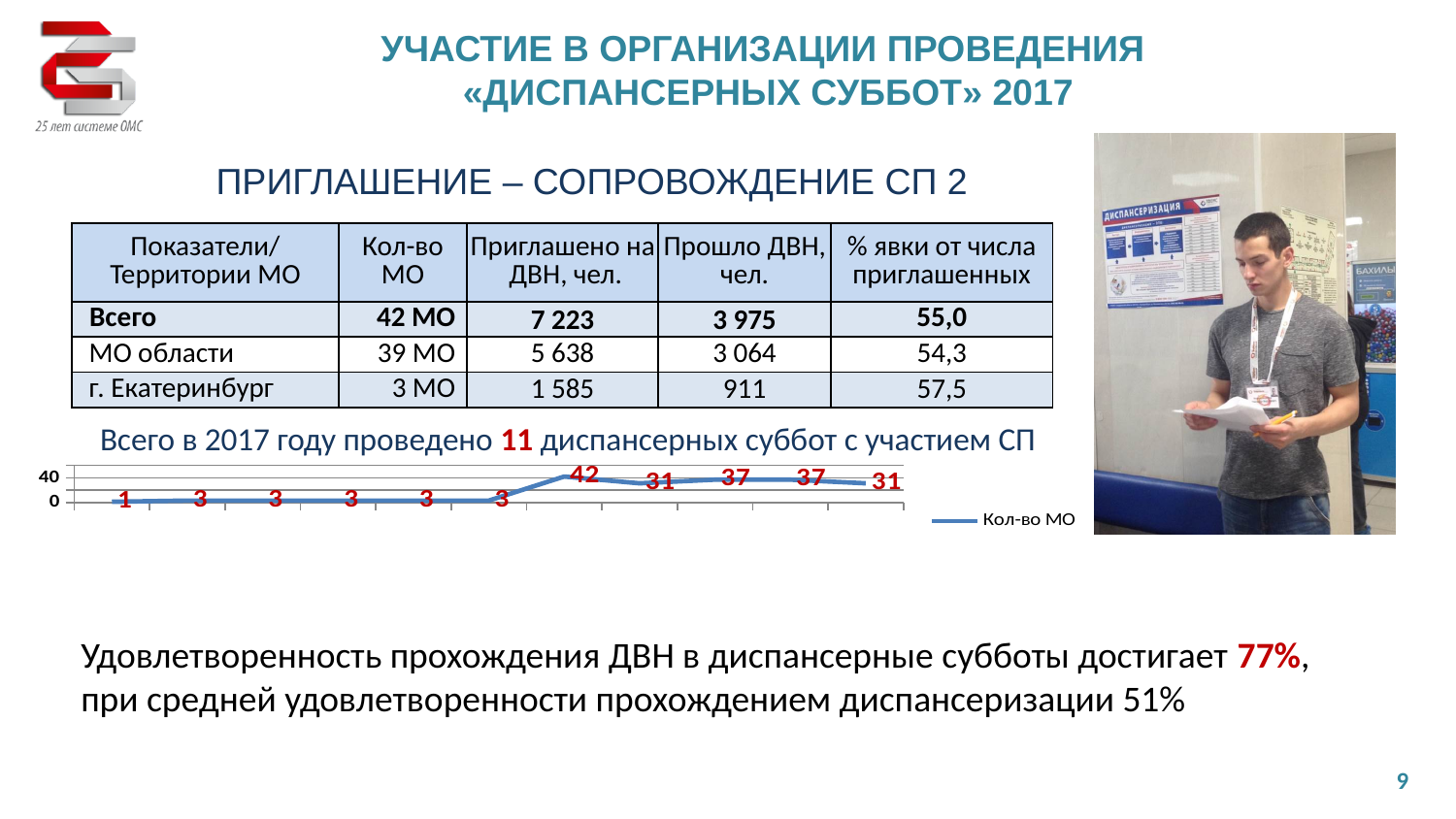
What is the difference between the highest labelled value (42) and the last data point (31) on the line chart? 11 Is the value of the seventh data point on the line chart greater or less than 40? greater What is the lowest value labelled on the line chart? 1 What is the highest value labelled on the line chart? 42 What is the value of the last data point on the line chart? 31 What is the value of the first data point on the line chart? 1 Which is larger on the line chart: the seventh data point or the eighth data point? the seventh data point (42) What is the name of the series shown in the chart legend? Кол-во МО How many data points are plotted on the line chart? 11 What kind of chart is shown on the slide? line chart How many series does the chart legend list? 1 What is the value of the seventh data point on the line chart? 42